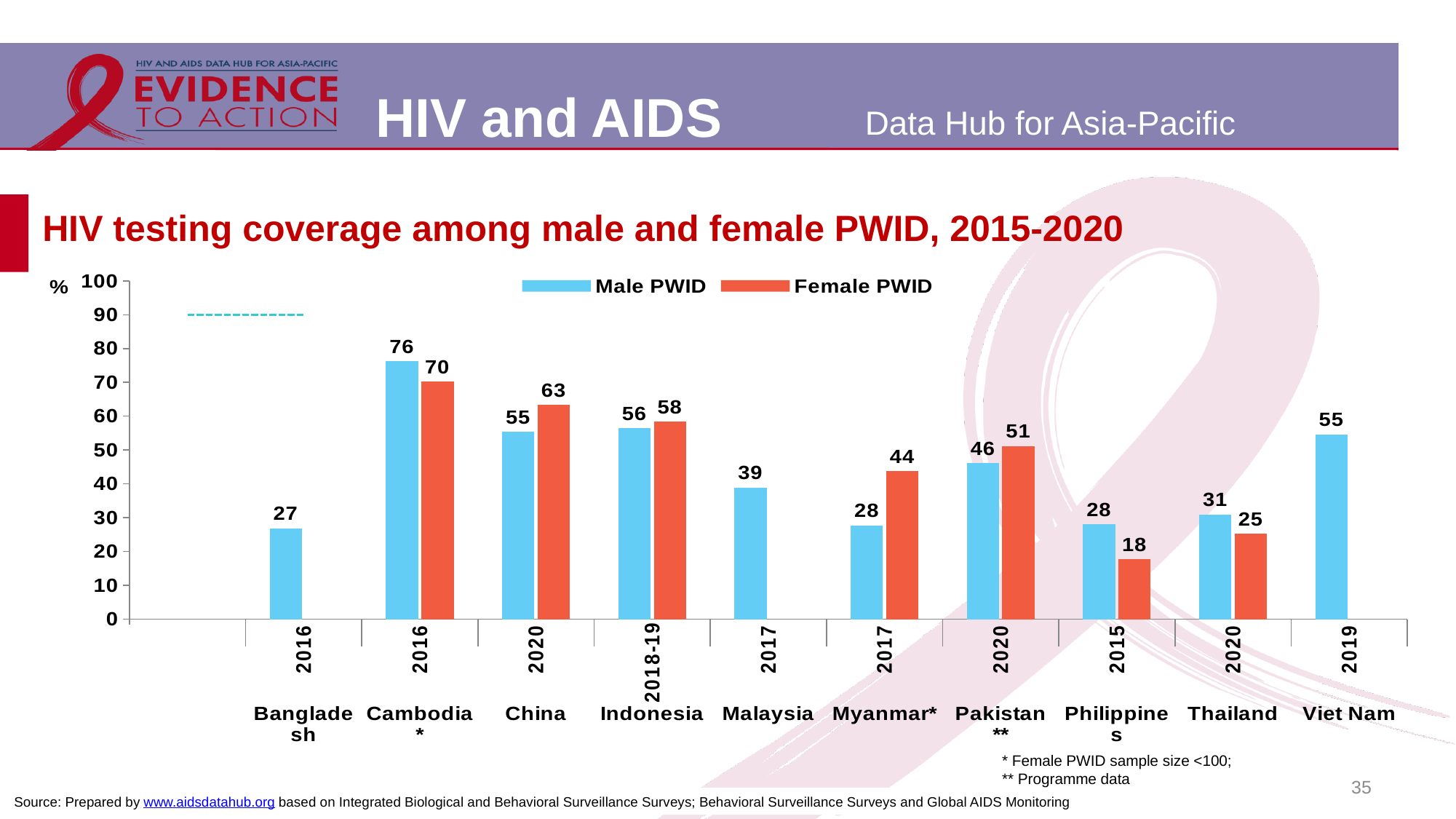
What is the value for female PWID in the Philippines? 18 How many series does the legend list? 2 What is the difference between female and male PWID testing coverage in Myanmar? 16 Which country has the lowest HIV testing coverage among female PWID? Philippines Which country has the highest HIV testing coverage among male PWID? Cambodia What is the HIV testing coverage among male PWID in Cambodia? 76 What kind of chart is shown on the slide? Bar chart Is the value for male PWID in Malaysia greater or less than 40? less In China, is HIV testing coverage higher among male PWID or female PWID? Female PWID What is the HIV testing coverage among female PWID in Myanmar? 44 Which colour represents Female PWID in the chart? Red How many countries are shown on the chart? 10